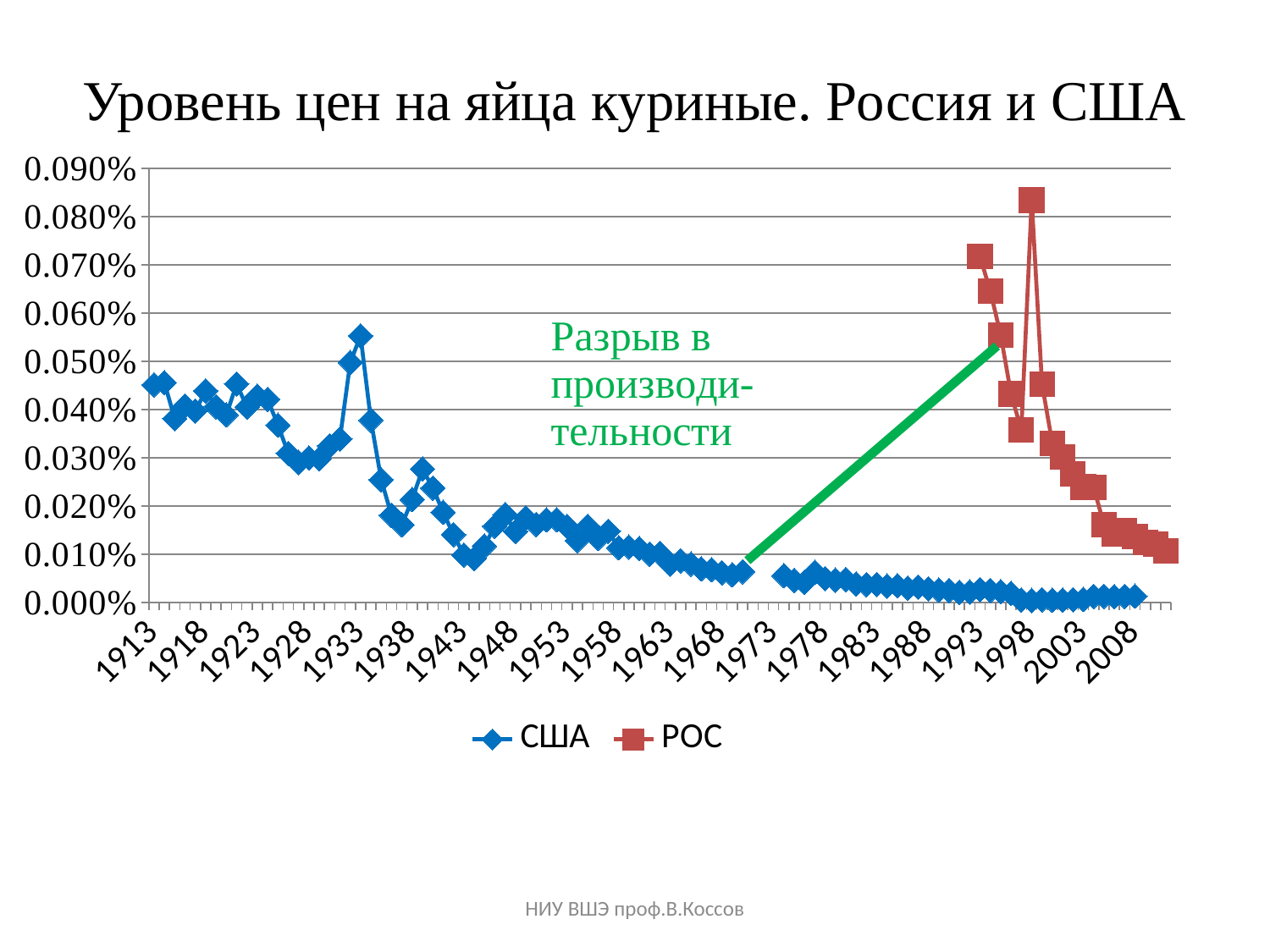
Is the value for США in 2008 greater or less than 0.010%? less Does the США series overall rise or fall from 1913 to 2008? fall Which two series are listed in the legend? США and РОС Is the value for США in 1913 greater or less than 0.030%? greater Is the highest value of the РОС series greater or less than 0.070%? greater What is the title of the chart? Уровень цен на яйца куриные. Россия и США Around 1998, which series has the larger value, США or РОС? РОС Does the РОС series overall rise or fall from 1993 to 2008? fall What kind of chart is shown on the slide? line chart How many series does the legend list? 2 Which series reaches the highest value on the chart? РОС